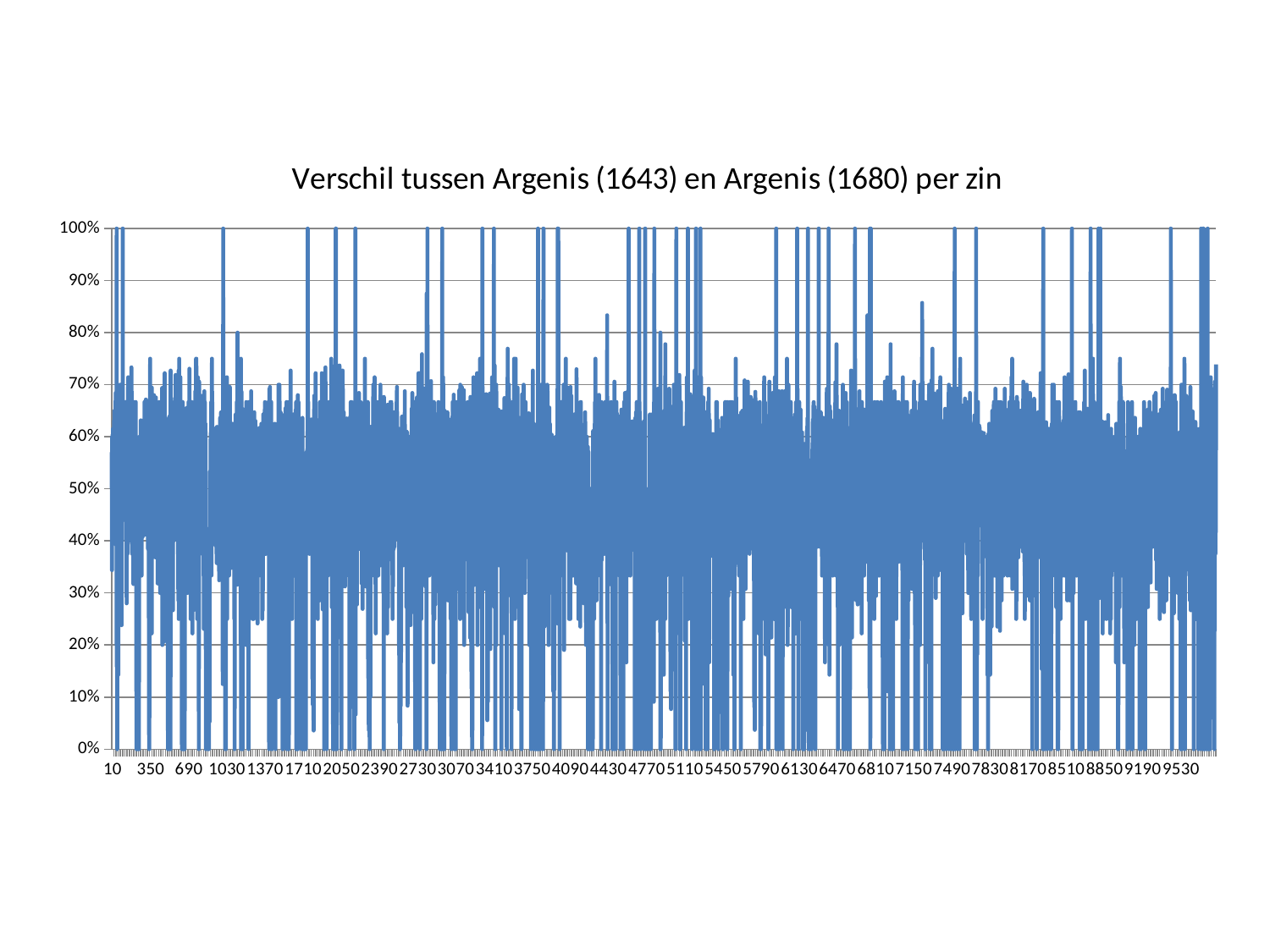
What is the lowest value reached by the plotted data? 0% What is the highest value reached by the plotted data? 100% What colour is the plotted data series? Blue What is the title of the chart? Verschil tussen Argenis (1643) en Argenis (1680) per zin